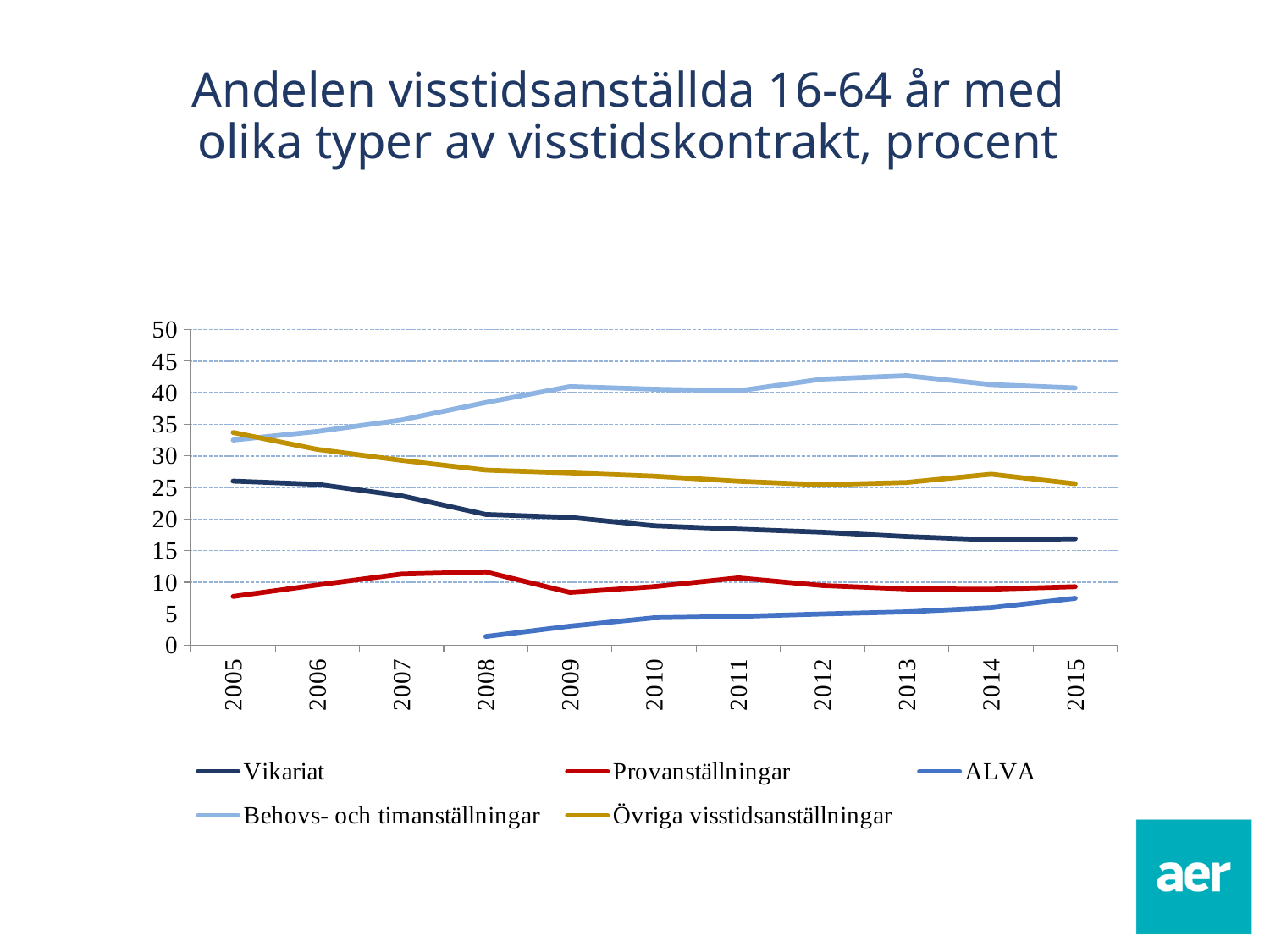
What kind of chart is shown on the slide? line chart How many years are shown on the x axis? 11 In 2010, which is larger: Vikariat or Övriga visstidsanställningar? Övriga visstidsanställningar Which series has the highest value in 2015? Behovs- och timanställningar Is the value for Behovs- och timanställningar in 2013 greater or less than 40? greater Does the Behovs- och timanställningar line rise or fall from 2005 to 2015? rise How many series does the legend list? 5 Is the value for Vikariat in 2015 greater or less than 20? less Is the value for Övriga visstidsanställningar in 2005 greater or less than 30? greater In which year does the ALVA series first appear on the chart? 2008 Which series has the lowest value in 2015? ALVA Does the Vikariat line rise or fall from 2005 to 2015? fall